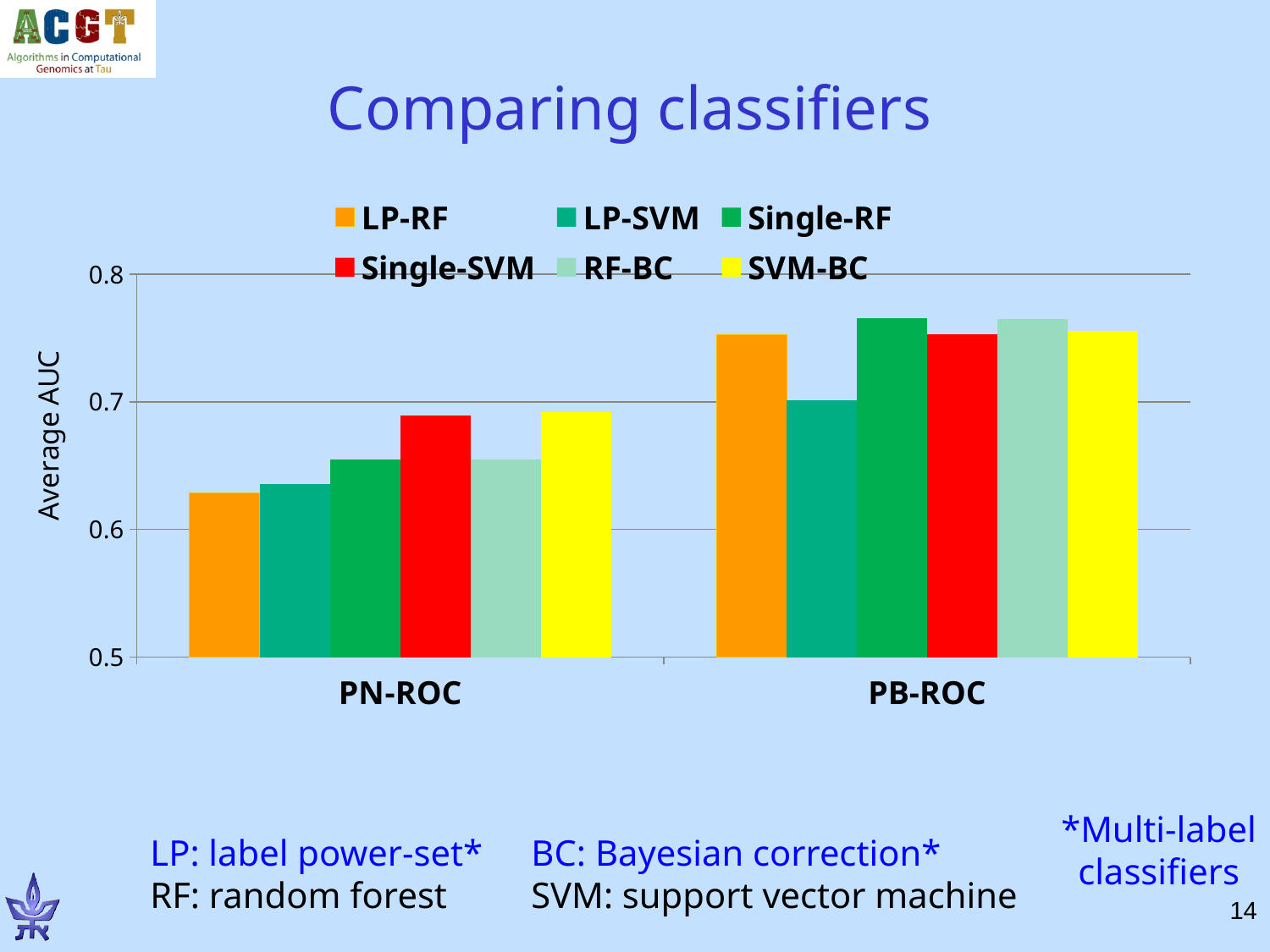
Do the values for LP-SVM rise or fall from PN-ROC to PB-ROC? rise Is the value for Single-RF in the PB-ROC category greater or less than 0.8? less Is the value for LP-RF in the PB-ROC category greater or less than 0.7? greater How many categories are shown on the x axis? 2 How many series does the legend list? 6 Which series has the lowest value in the PB-ROC category? LP-SVM Is the value for LP-RF in the PN-ROC category greater or less than 0.7? less In the PN-ROC category, which is larger: Single-SVM or LP-RF? Single-SVM What is the label of the y axis? Average AUC What kind of chart is shown on the slide? bar chart What is the title of the slide's chart? Comparing classifiers